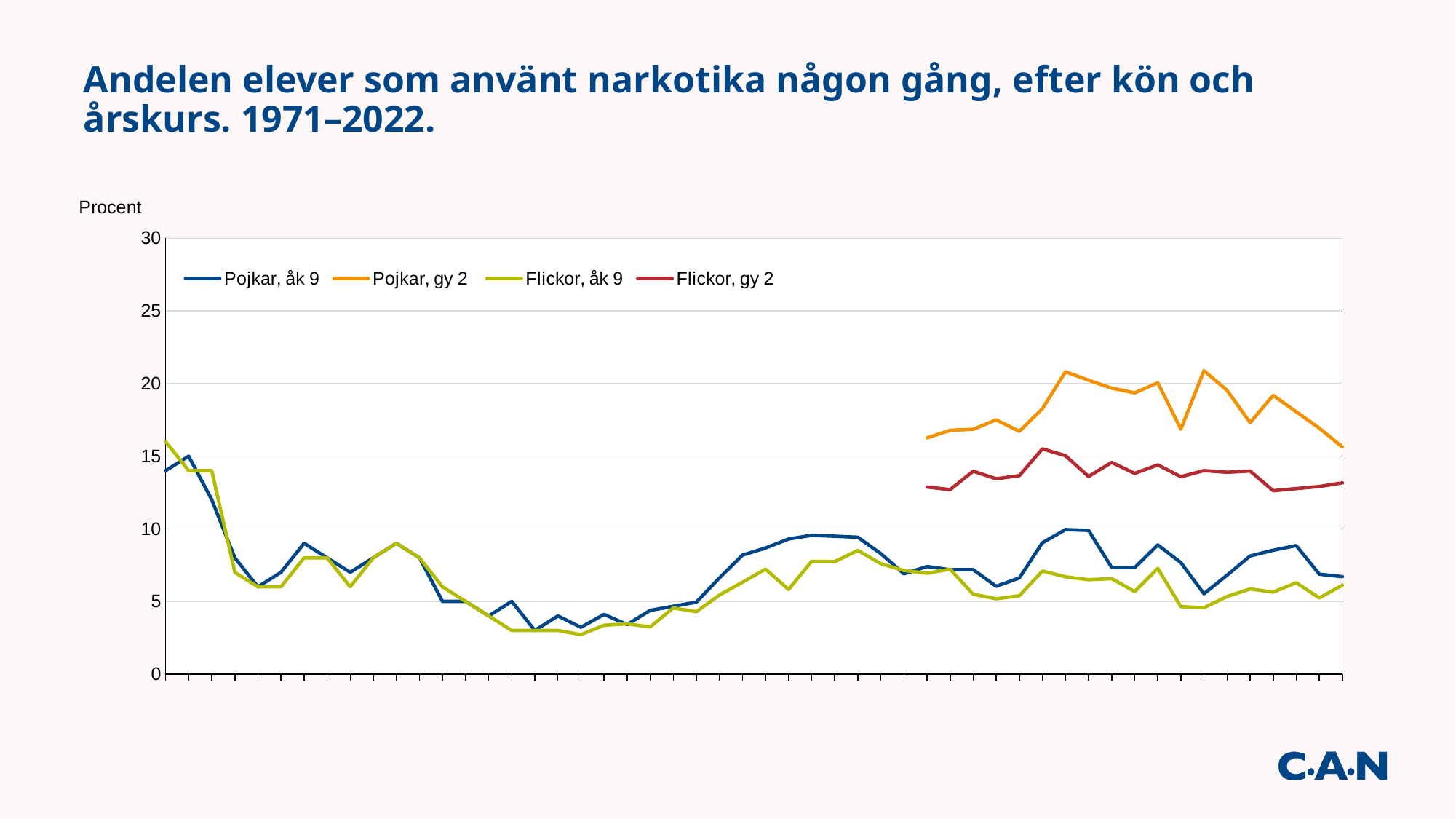
Over its last few points, does the Pojkar, gy 2 line rise or fall? fall Is the last value of the Pojkar, gy 2 line greater or less than 20? less Is the highest point of the Pojkar, gy 2 line greater or less than 20? greater At the right end of the chart, is the Pojkar, åk 9 line higher or lower than the Flickor, åk 9 line? higher Is the lowest point of the Flickor, åk 9 line greater or less than 5? less What label is shown on the vertical axis? Procent What kind of chart is shown on the slide? line chart How many series does the legend list? 4 Which series has the lowest values at the right end of the chart? Flickor, åk 9 Which series reaches the highest value on the chart? Pojkar, gy 2 What is the title of the chart? Andelen elever som använt narkotika någon gång, efter kön och årskurs. 1971–2022.